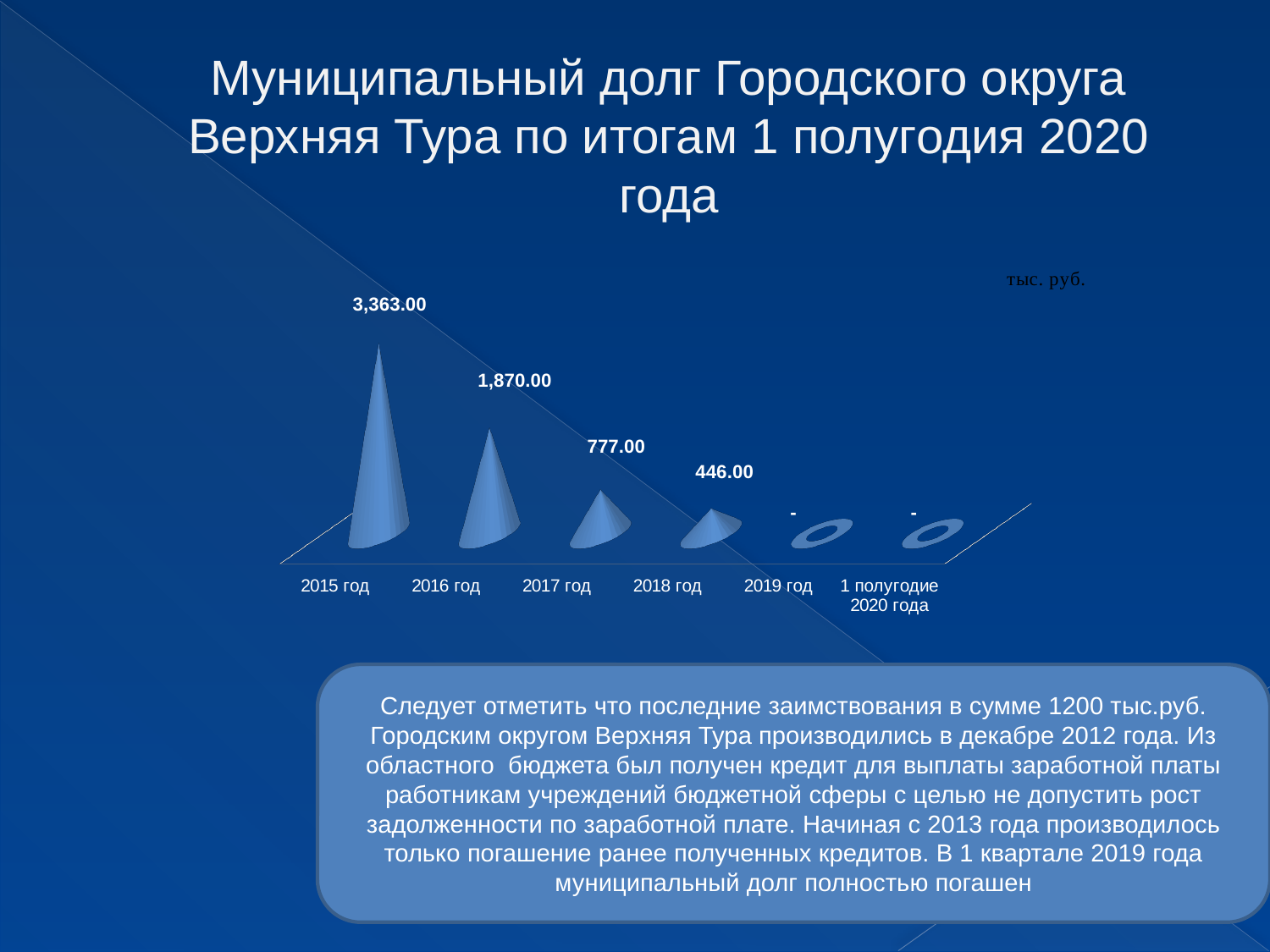
How many categories are shown on the x axis? 6 What is the value for 2015 год? 3,363.00 What unit is indicated for the chart values? тыс. руб. Which is larger, the value for 2016 год or the value for 2017 год? 2016 год What is the value for 2016 год? 1,870.00 What is the value for 2018 год? 446.00 What is the difference between the values for 2017 год and 2018 год? 331.00 What is the data label shown for 2019 год? - What is the value for 2017 год? 777.00 Which category has the highest value? 2015 год Do the values rise or fall from 2015 год to 2018 год? fall What is the difference between the values for 2015 год and 2016 год? 1,493.00